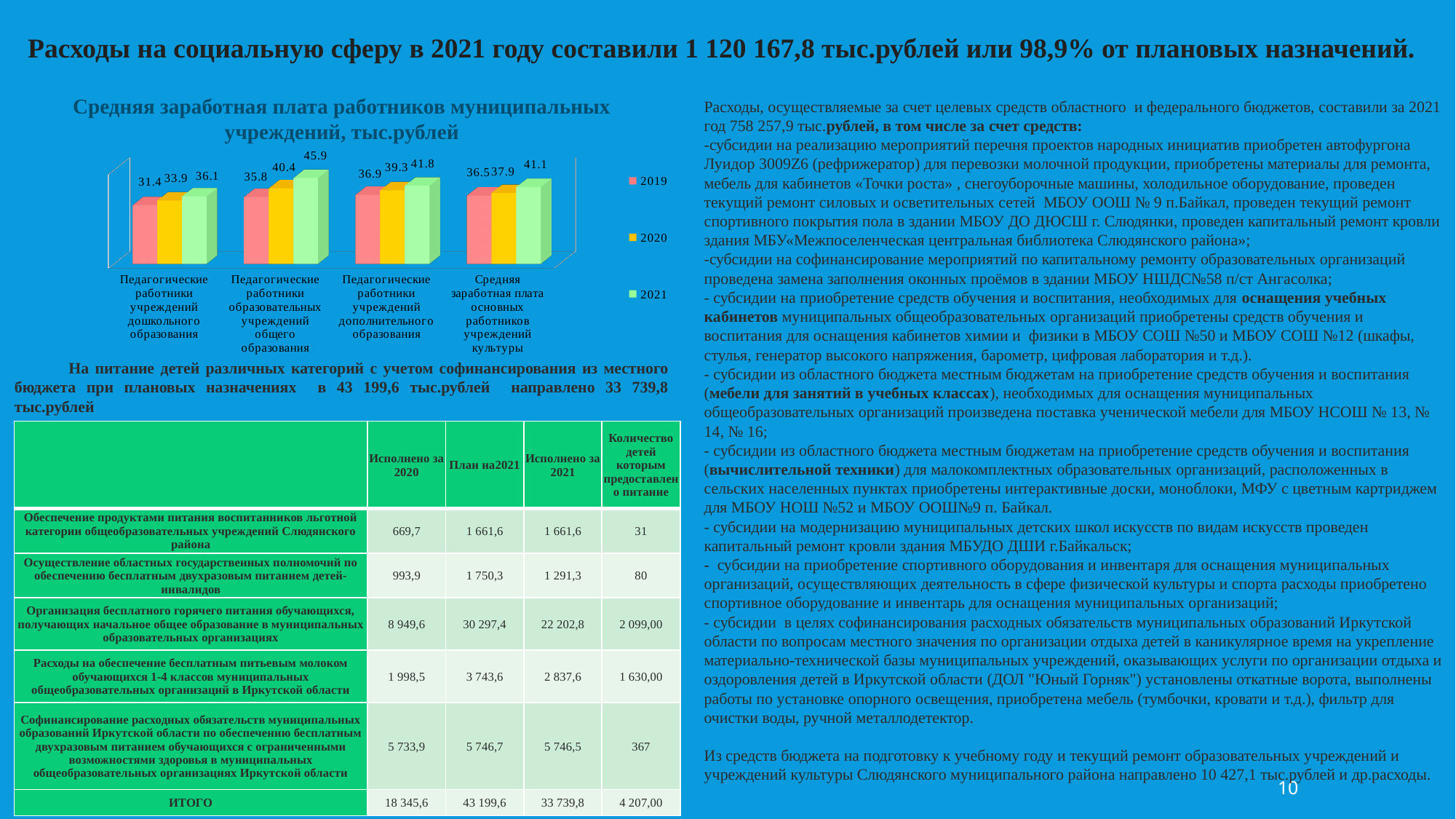
What is the 2021 value for 'Педагогические работники образовательных учреждений общего образования'? 45.9 What type of chart is shown under the title 'Средняя заработная плата работников муниципальных учреждений, тыс.рублей'? bar chart What is the 2019 value for 'Педагогические работники дошкольного образования'? 31.4 Which legend entry is shown in green in the chart? 2021 How many categories are shown along the x axis of the chart? 4 How many series does the legend of the chart list? 3 Which category has the highest 2021 value? Педагогические работники образовательных учреждений общего образования Which category has the lowest 2019 value? Педагогические работники учреждений дошкольного образования What is the 2020 value for 'Средняя заработная плата основных работников учреждений культуры'? 37.9 What is the difference between the 2021 and 2019 values for 'Педагогические работники образовательных учреждений общего образования'? 10.1 Which is larger: the 2020 value for 'Педагогические работники учреждений дополнительного образования' or the 2020 value for 'Педагогические работники образовательных учреждений общего образования'? Педагогические работники образовательных учреждений общего образования For 'Педагогические работники дошкольного образования', do the values rise or fall from 2019 to 2021? rise